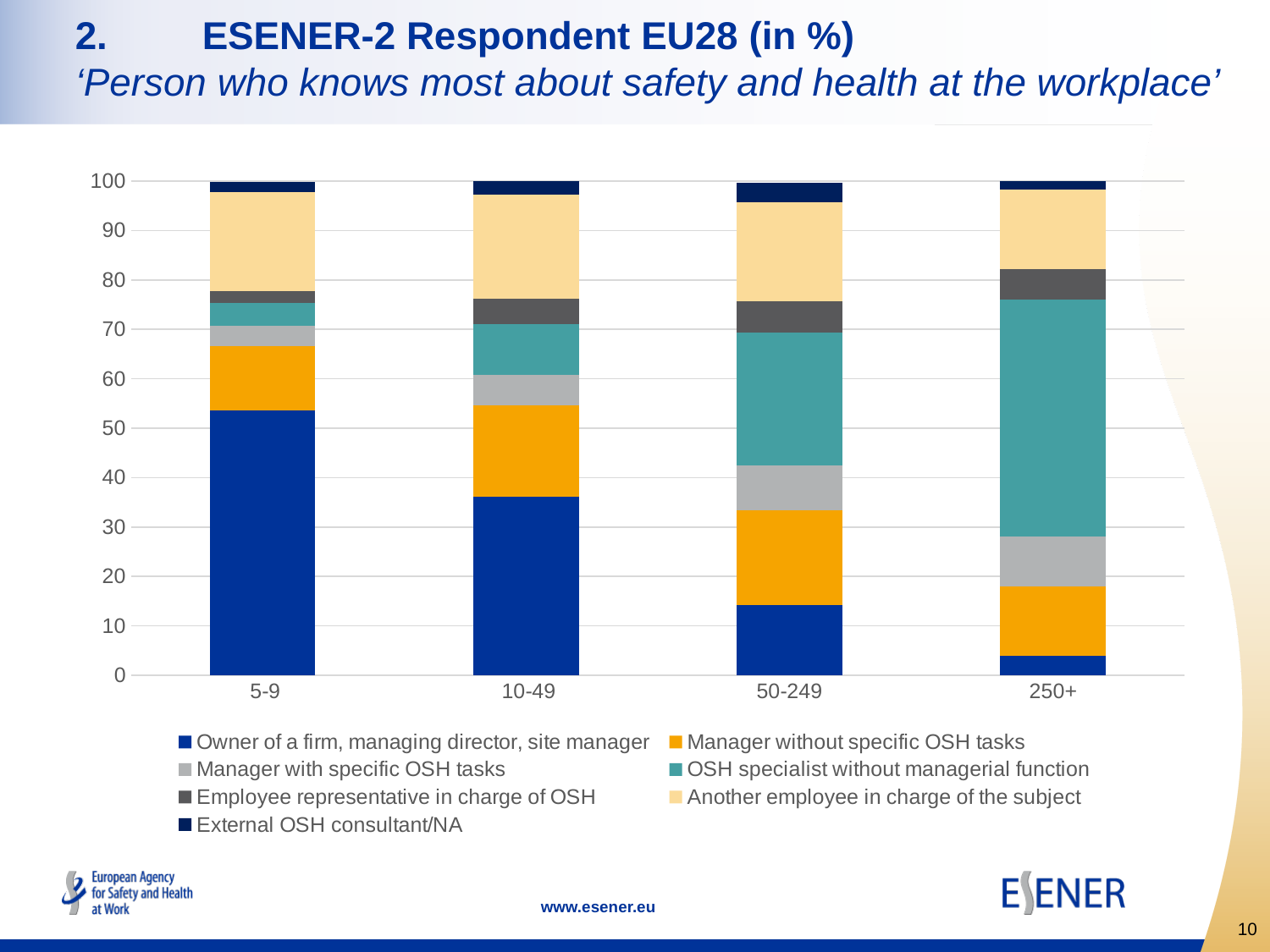
How many establishment size categories are shown on the x axis? 4 Is the 'OSH specialist without managerial function' segment larger for 5-9 or for 50-249? 50-249 Is the 'Owner of a firm, managing director, site manager' value for 250+ greater or less than 10? less What colour represents 'Owner of a firm, managing director, site manager' in the chart? Dark blue What kind of chart is shown on the slide? Stacked bar chart Is the 'Owner of a firm, managing director, site manager' value for 10-49 greater or less than 30? greater Which size category has the largest 'OSH specialist without managerial function' segment? 250+ Is the 'Owner of a firm, managing director, site manager' segment larger for 5-9 or for 250+? 5-9 Which size category has the smallest 'Owner of a firm, managing director, site manager' segment? 250+ How many series does the legend list? 7 Does the 'Owner of a firm, managing director, site manager' share rise or fall as establishment size increases from 5-9 to 250+? fall Which size category has the largest 'Owner of a firm, managing director, site manager' segment? 5-9